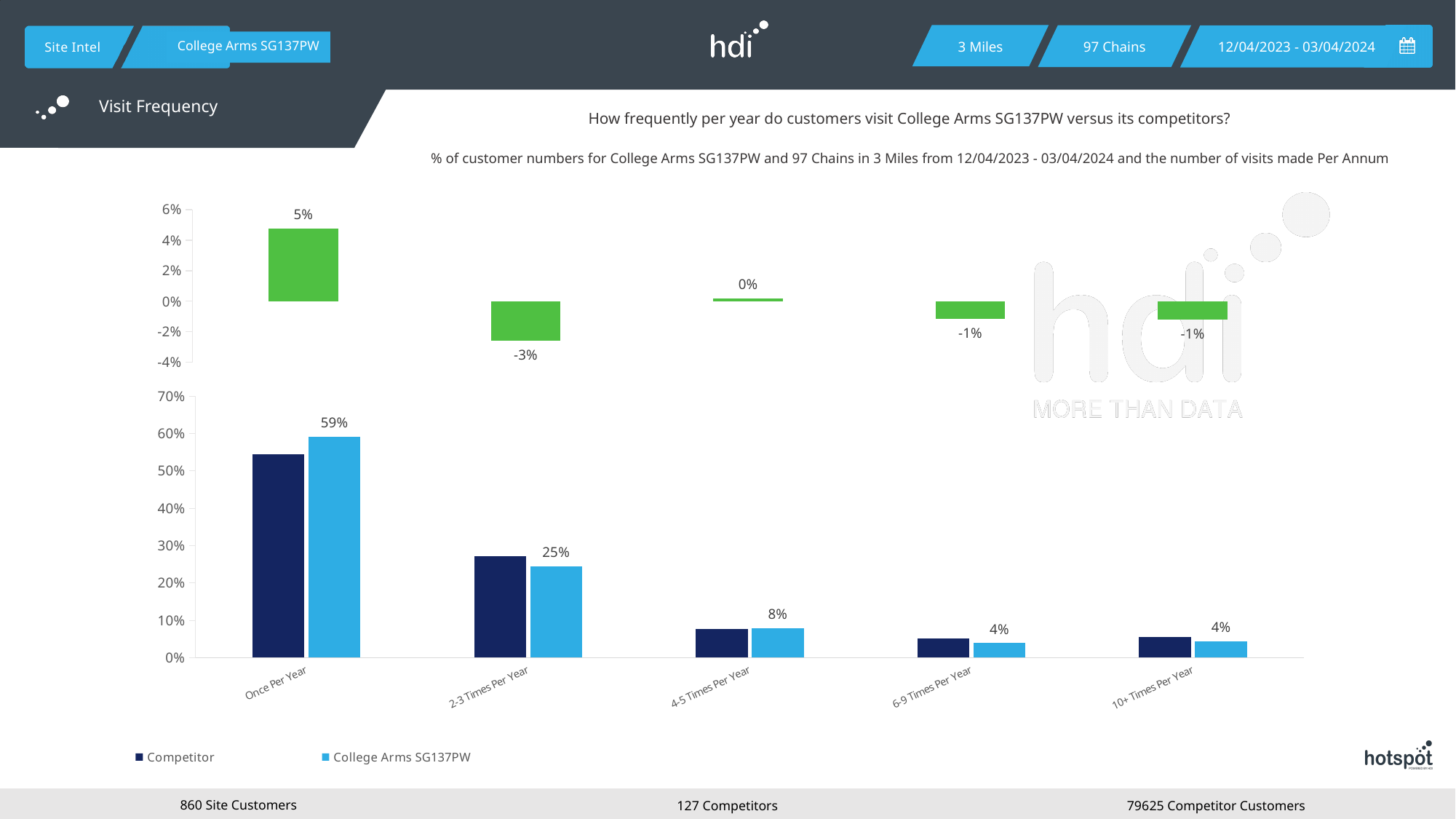
In the bottom chart, what is the difference between the College Arms SG137PW values for Once Per Year and 2-3 Times Per Year? 34 percentage points In the bottom chart, what is the value for College Arms SG137PW in the Once Per Year category? 59% In the bottom chart, is the Competitor value for Once Per Year greater or less than 50%? greater How many categories are shown on the x axis of the bottom chart? 5 In the bottom chart, which series has the larger value for Once Per Year, Competitor or College Arms SG137PW? College Arms SG137PW In the top chart, what is the value shown for 2-3 Times Per Year? -3% In the bottom chart, do the College Arms SG137PW values rise or fall from Once Per Year to 10+ Times Per Year? fall In the bottom chart, which category has the highest value for College Arms SG137PW? Once Per Year In the top chart, what is the value shown for Once Per Year? 5% What kind of chart is the bottom chart? bar chart In the top chart, which category has the lowest value? 2-3 Times Per Year How many series does the legend of the bottom chart list? 2